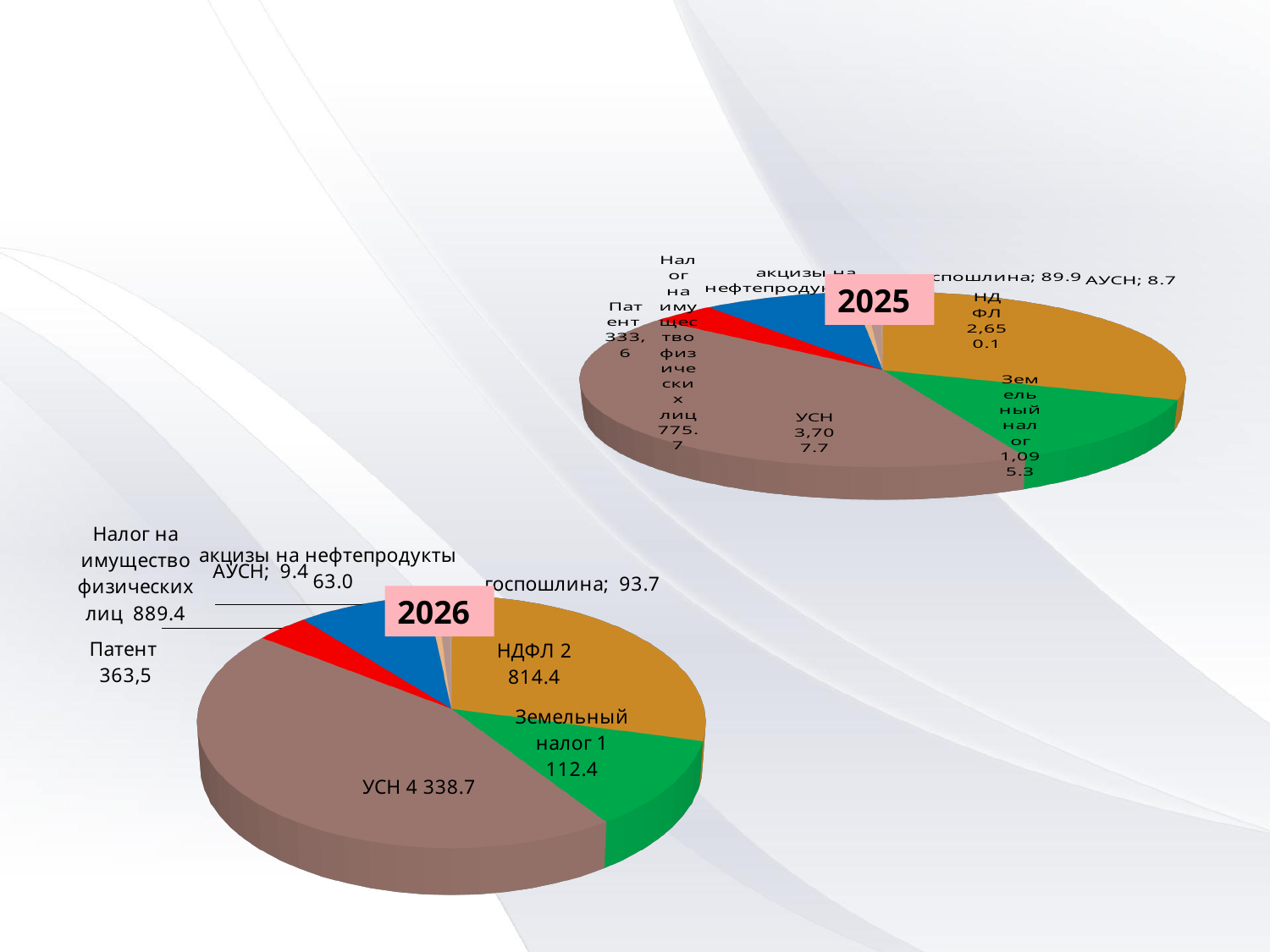
In the 2026 chart, which category has the smallest value? АУСН In the 2025 chart, what is the value for Земельный налог? 1,095.3 In the 2026 chart, what is the value for Земельный налог? 1 112.4 In the 2026 chart, what is the value for УСН? 4 338.7 In the 2026 chart, what is the difference between госпошлина and АУСН? 84.3 How many categories are shown in the 2026 pie chart? 8 In the 2026 chart, which category has the largest slice? УСН In the 2026 chart, what is the value for госпошлина? 93.7 What type of chart is used for the 2026 data? pie chart In the 2026 chart, what is the value for НДФЛ? 2 814.4 In the 2025 chart, which is larger: НДФЛ or Земельный налог? НДФЛ In the 2025 chart, what is the value for АУСН? 8.7